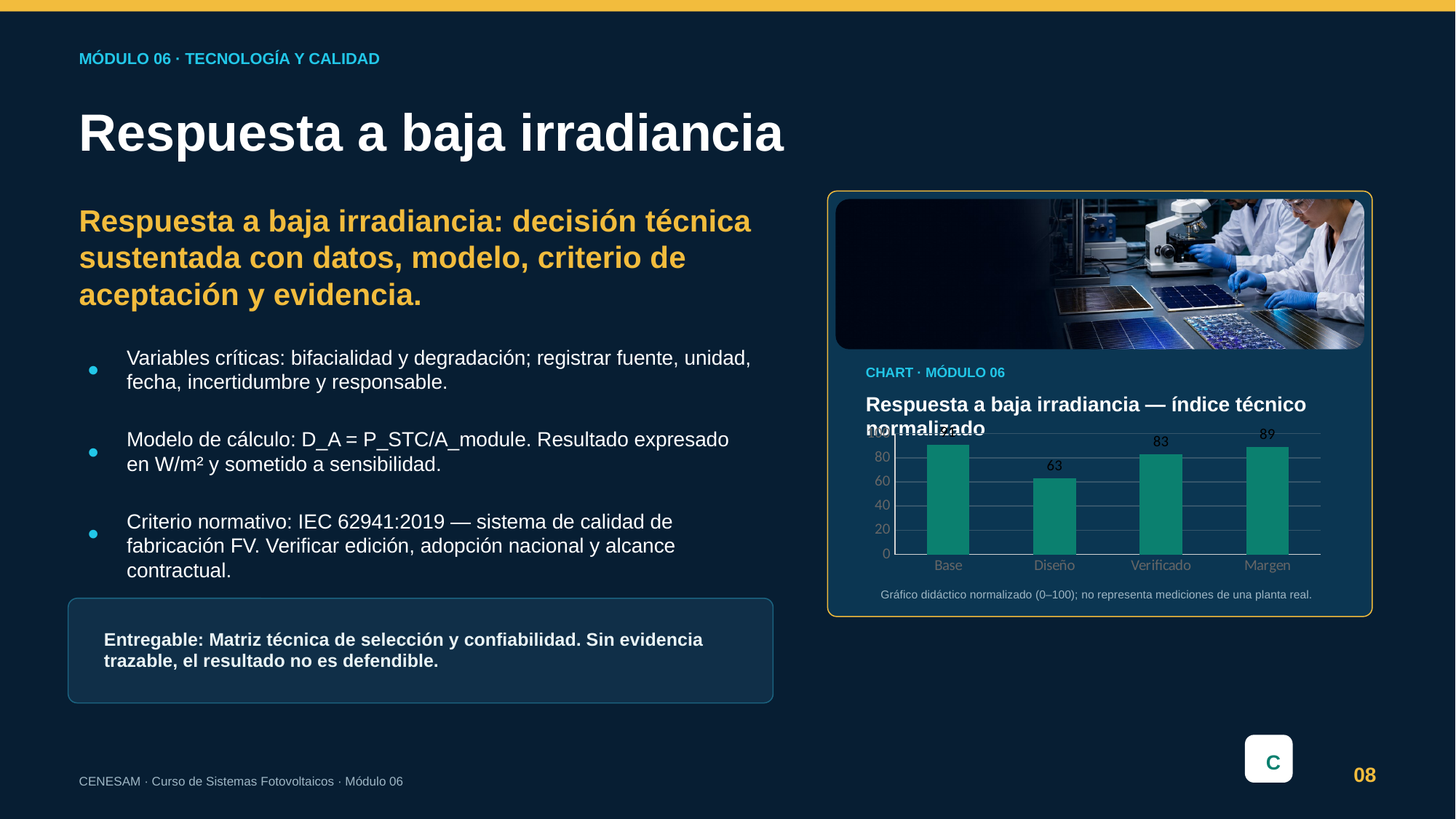
What is the difference between the values for Verificado and Diseño? 20 What is the value for Verificado in the chart? 83 What is the value for Margen in the chart? 89 What kind of chart is shown on the slide? Bar chart Which is larger, the value for Verificado or the value for Margen? Margen What is the difference between the values for Margen and Verificado? 6 How many categories are shown on the x axis of the chart? 4 What is the title of the chart? Respuesta a baja irradiancia — índice técnico normalizado What is the value for Diseño in the chart? 63 Which category has the lowest value in the chart? Diseño Is the value for Diseño greater or less than 80? less Is the value for Base greater or less than 80? greater